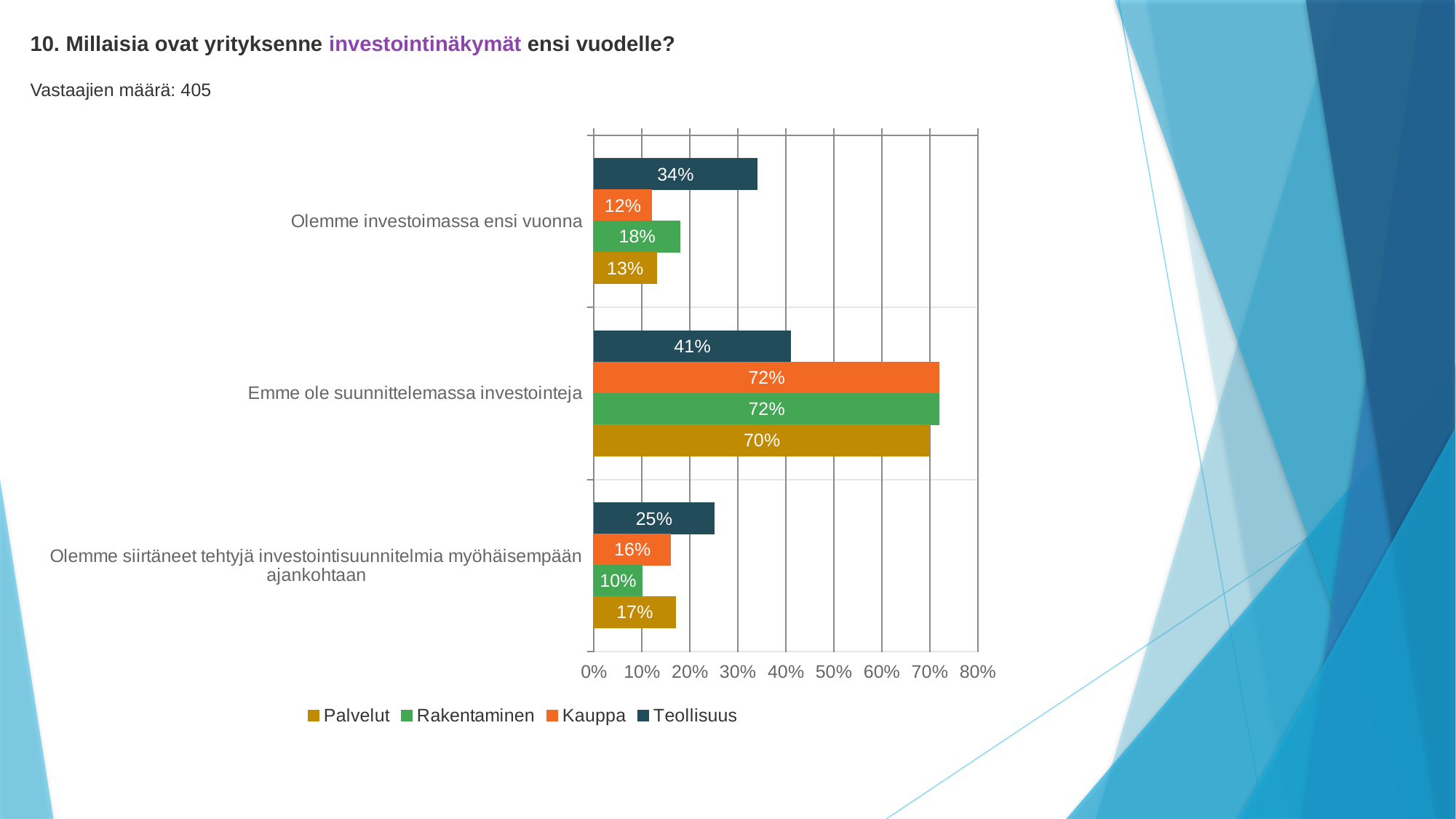
In the category "Olemme siirtäneet tehtyjä investointisuunnitelmia myöhäisempään ajankohtaan", which is larger: the value for Palvelut or the value for Kauppa? Palvelut What is the difference between the Teollisuus and Kauppa values in the category "Olemme investoimassa ensi vuonna"? 22% Is the value for Kauppa in the category "Emme ole suunnittelemassa investointeja" greater or less than 50%? greater What is the value for Teollisuus in the category "Olemme investoimassa ensi vuonna"? 34% Which series has the highest value in the category "Olemme investoimassa ensi vuonna"? Teollisuus What kind of chart is shown on the slide? bar chart Which series is shown in orange in the legend? Kauppa What is the value for Rakentaminen in the category "Olemme siirtäneet tehtyjä investointisuunnitelmia myöhäisempään ajankohtaan"? 10% Which series has the lowest value in the category "Emme ole suunnittelemassa investointeja"? Teollisuus What is the value for Palvelut in the category "Emme ole suunnittelemassa investointeja"? 70% How many categories are shown on the chart? 3 How many series does the legend list? 4